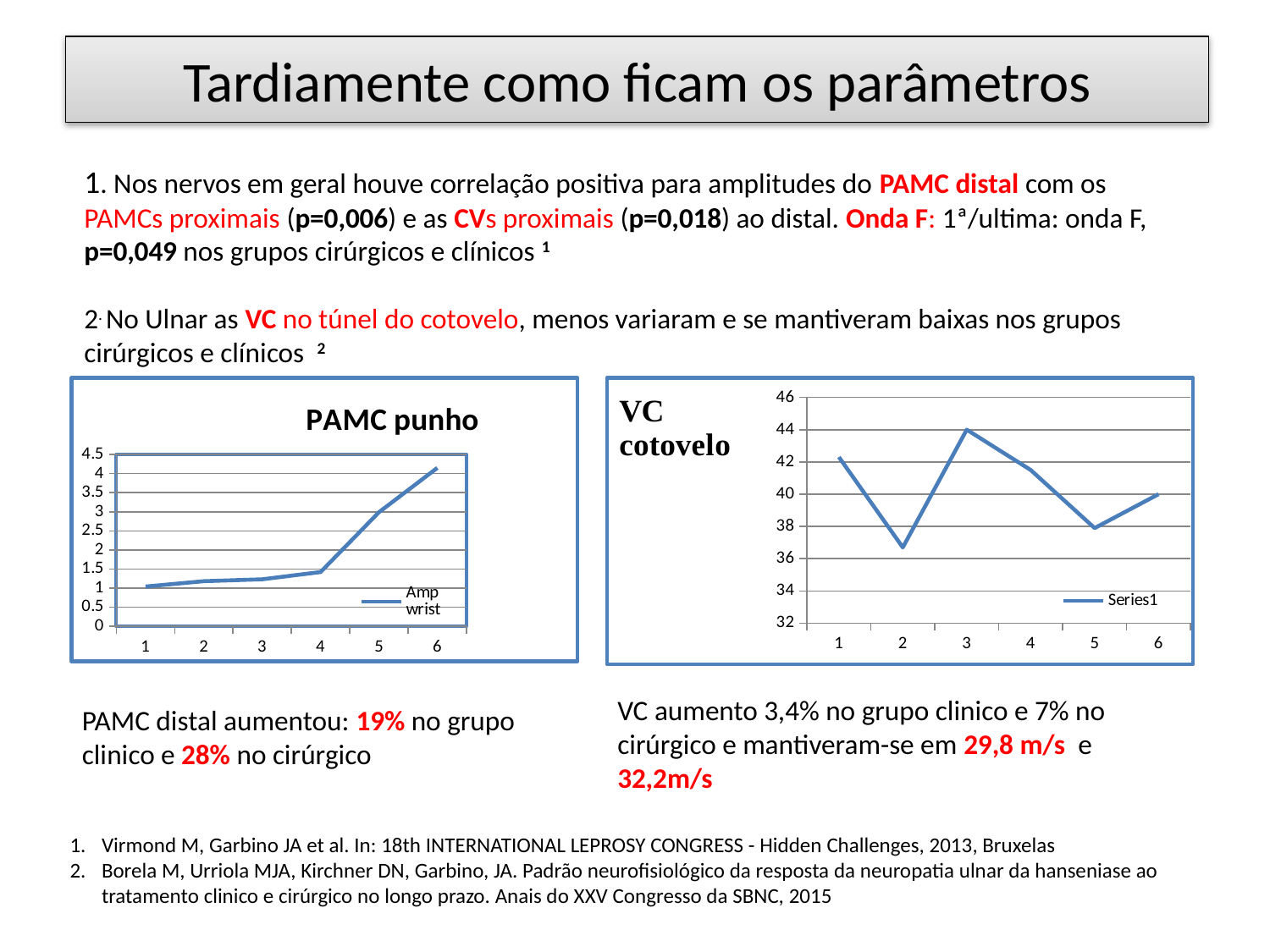
In the 'PAMC punho' chart, how many points are plotted along the x axis? 6 What type of chart is the 'PAMC punho' chart? line chart What type of chart is the 'VC cotovelo' chart? line chart In the 'VC cotovelo' chart, at which x-axis point is the value lowest? 2 In the 'PAMC punho' chart, at which x-axis point is the value highest? 6 In the 'VC cotovelo' chart, at which x-axis point is the value highest? 3 In the 'PAMC punho' chart, what is the name of the series shown in the legend? Amp wrist In the 'PAMC punho' chart, do the values generally rise or fall from point 1 to point 6? rise In the 'VC cotovelo' chart, how many series does the legend list? 1 In the 'PAMC punho' chart, is the value at point 4 greater or less than 2? less In the 'VC cotovelo' chart, is the value at point 2 greater or less than 38? less In the 'PAMC punho' chart, is the value at point 6 greater or less than 3.5? greater